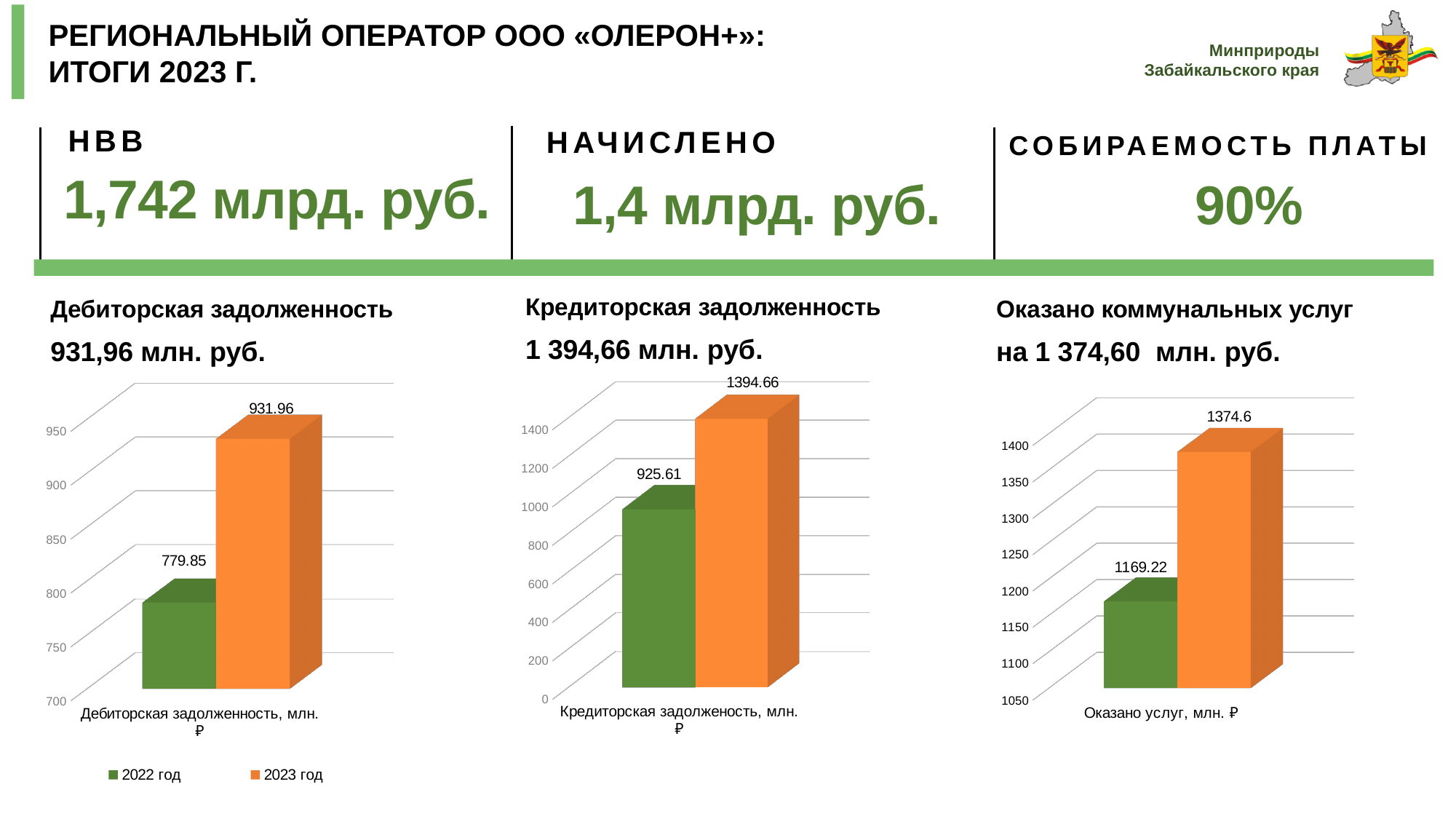
In the middle chart (Кредиторская задолженность), what is the value for 2023 год? 1394.66 In the left chart (Дебиторская задолженность), what is the value for 2022 год? 779.85 In the middle chart (Кредиторская задолженность), which year has the larger value, 2022 год or 2023 год? 2023 год In the middle chart (Кредиторская задолженность), what is the difference between the 2023 год and 2022 год values? 469.05 In the left chart (Дебиторская задолженность), what is the difference between the 2023 год and 2022 год values? 152.11 In the middle chart (Кредиторская задолженность), what is the value for 2022 год? 925.61 In the right chart (Оказано услуг), what is the difference between the 2023 год and 2022 год values? 205.38 How many series does the legend under the left chart list? 2 In the right chart (Оказано услуг), what is the value for 2022 год? 1169.22 In the right chart (Оказано услуг), what is the value for 2023 год? 1374.6 In the left chart (Дебиторская задолженность), what is the value for 2023 год? 931.96 What kind of chart is the right chart (Оказано услуг)? bar chart